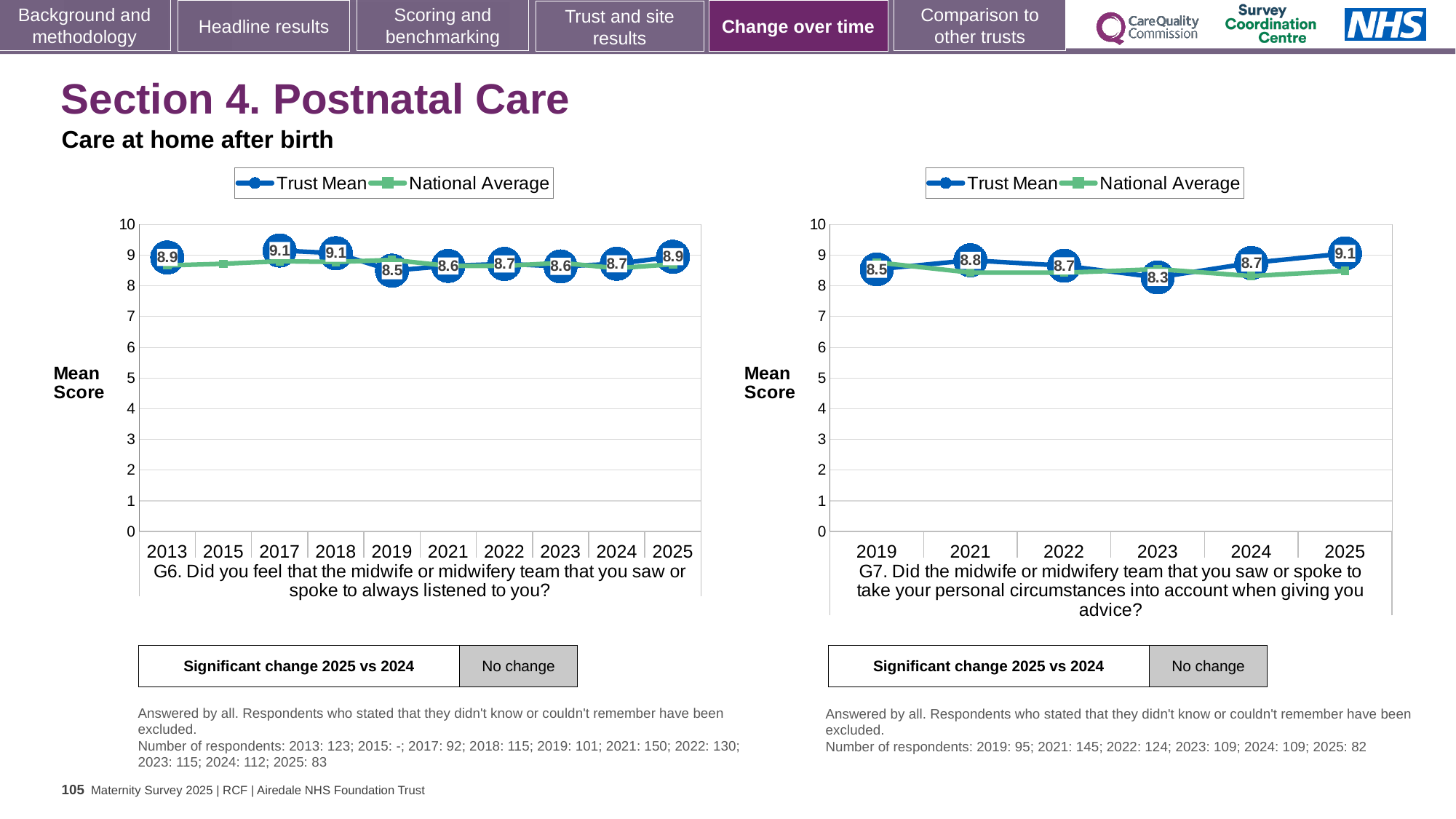
In the G6 chart on the left, what is the Trust Mean score for 2025? 8.9 How many series does the legend of the G6 chart on the left list? 2 In the G7 chart on the right, which year has the highest Trust Mean score? 2025 In the G7 chart on the right, what is the Trust Mean score for 2025? 9.1 In the G7 chart on the right, which year has the lowest Trust Mean score? 2023 What kind of chart is the G7 chart on the right? Line chart How many years are shown on the x axis of the G7 chart on the right? 6 In the G6 chart on the left, which year has the larger Trust Mean score, 2017 or 2019? 2017 In the G6 chart on the left, what is the Trust Mean score for 2019? 8.5 In the G6 chart on the left, which year has the lowest Trust Mean score? 2019 In the G7 chart on the right, what is the difference between the Trust Mean scores for 2025 and 2023? 0.8 In the G7 chart on the right, what is the Trust Mean score for 2023? 8.3